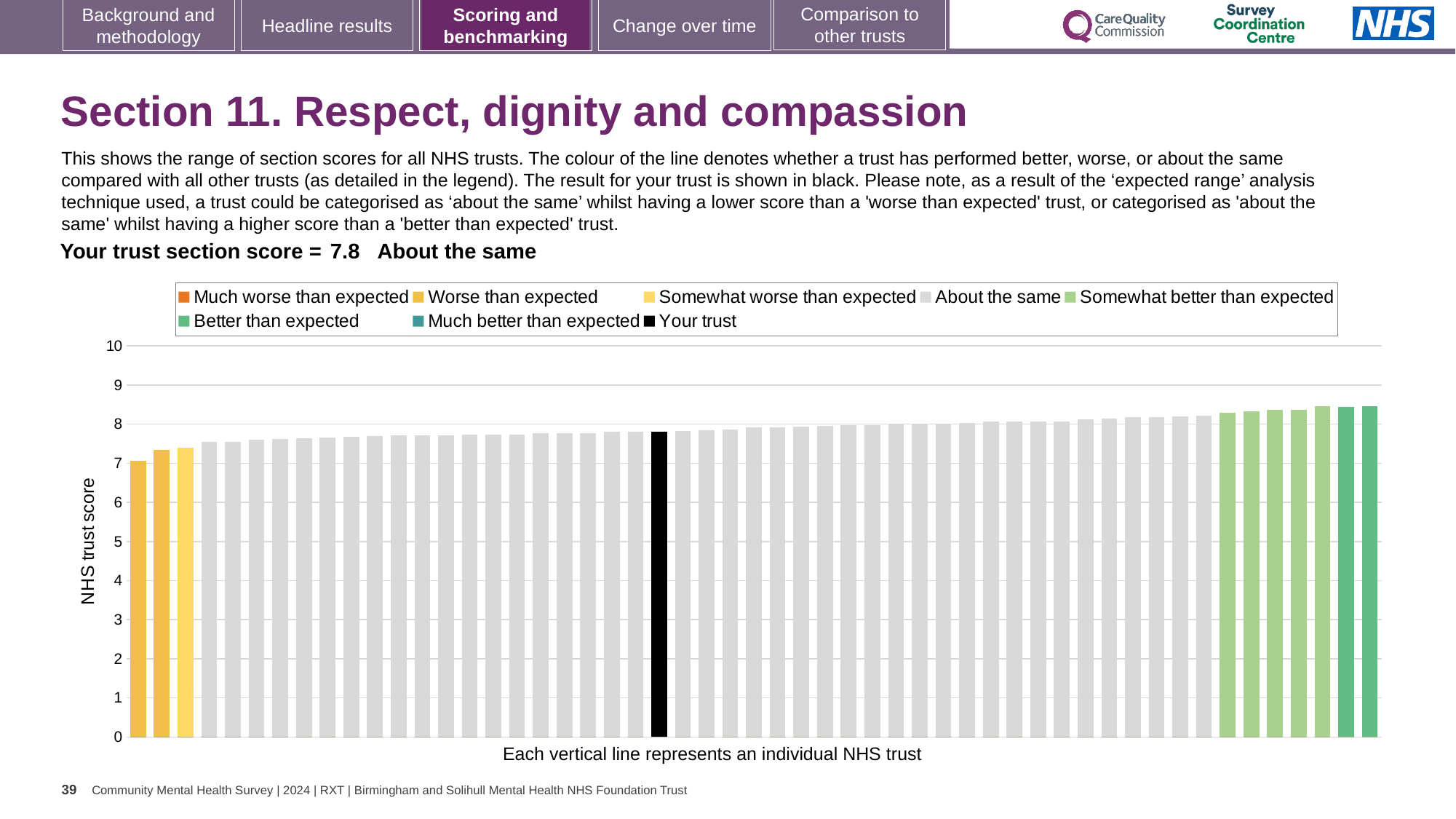
What is the section score for your trust shown on the slide? 7.8 Is the value of the black bar (your trust) greater or less than 9? less Which category is your trust's section score placed in? About the same What is the label on the vertical axis of the chart? NHS trust score Do the trust scores rise or fall from left to right along the x axis? rise Is the value of the rightmost bar greater or less than 8? greater What colour is used for the 'Your trust' bar in the chart? black Is the value of the leftmost bar greater or less than 6? greater What kind of chart is shown on the slide? bar chart How many entries does the chart legend list? 8